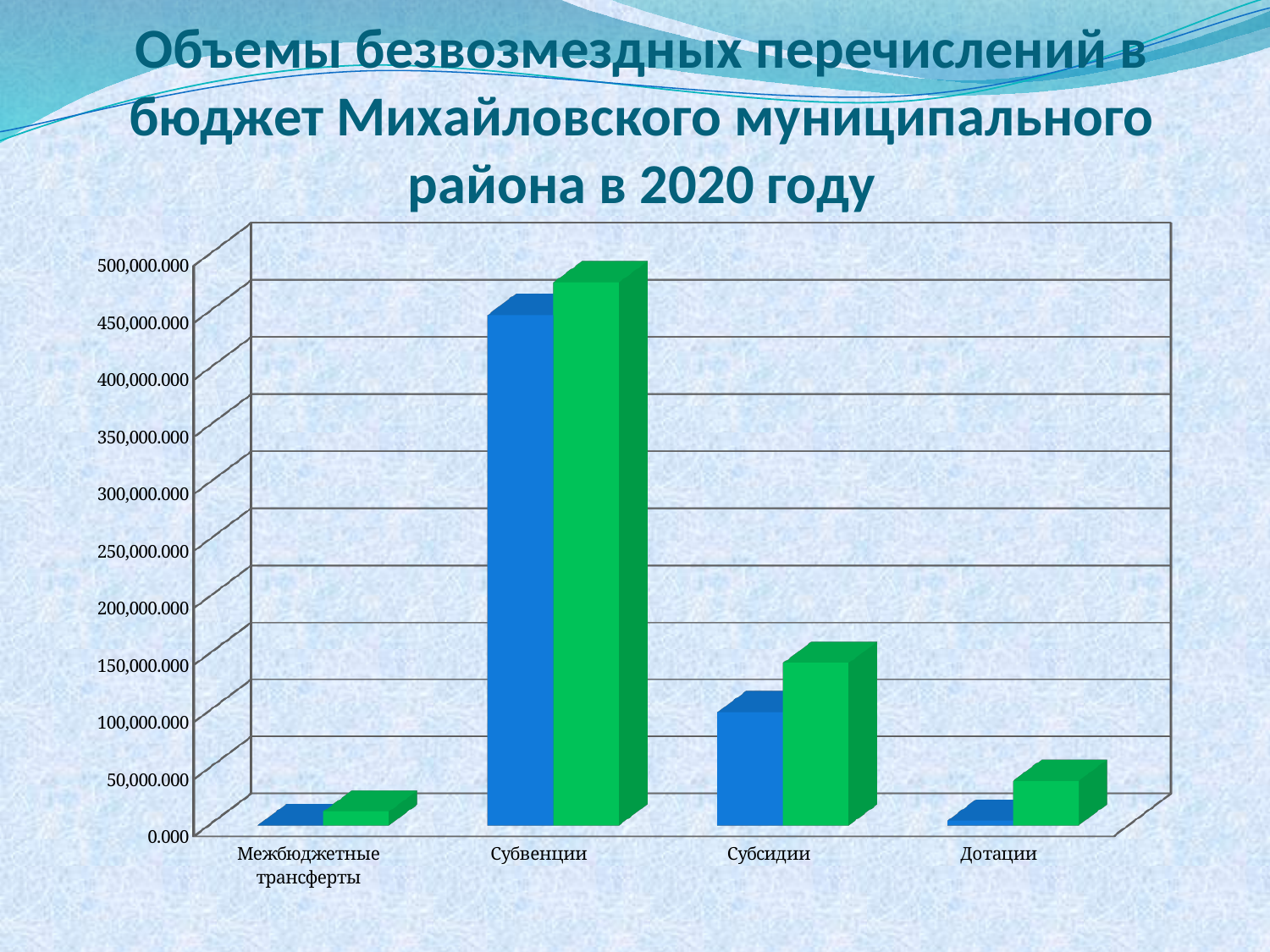
Which category has the larger green bar, Субсидии or Дотации? Субсидии Is the blue bar for Субсидии greater or less than 150,000.000? less For Субсидии, which bar is taller, the blue one or the green one? the green one Is the blue bar for Межбюджетные трансферты greater or less than 50,000.000? less How many categories are shown on the x axis of the chart? 4 What is the title of the chart on the slide? Объемы безвозмездных перечислений в бюджет Михайловского муниципального района в 2020 году Which category has the lowest green bar in the chart? Межбюджетные трансферты Is the green bar for Субвенции greater or less than 450,000.000? greater Which category has the highest bars in the chart? Субвенции What kind of chart is shown on the slide? bar chart